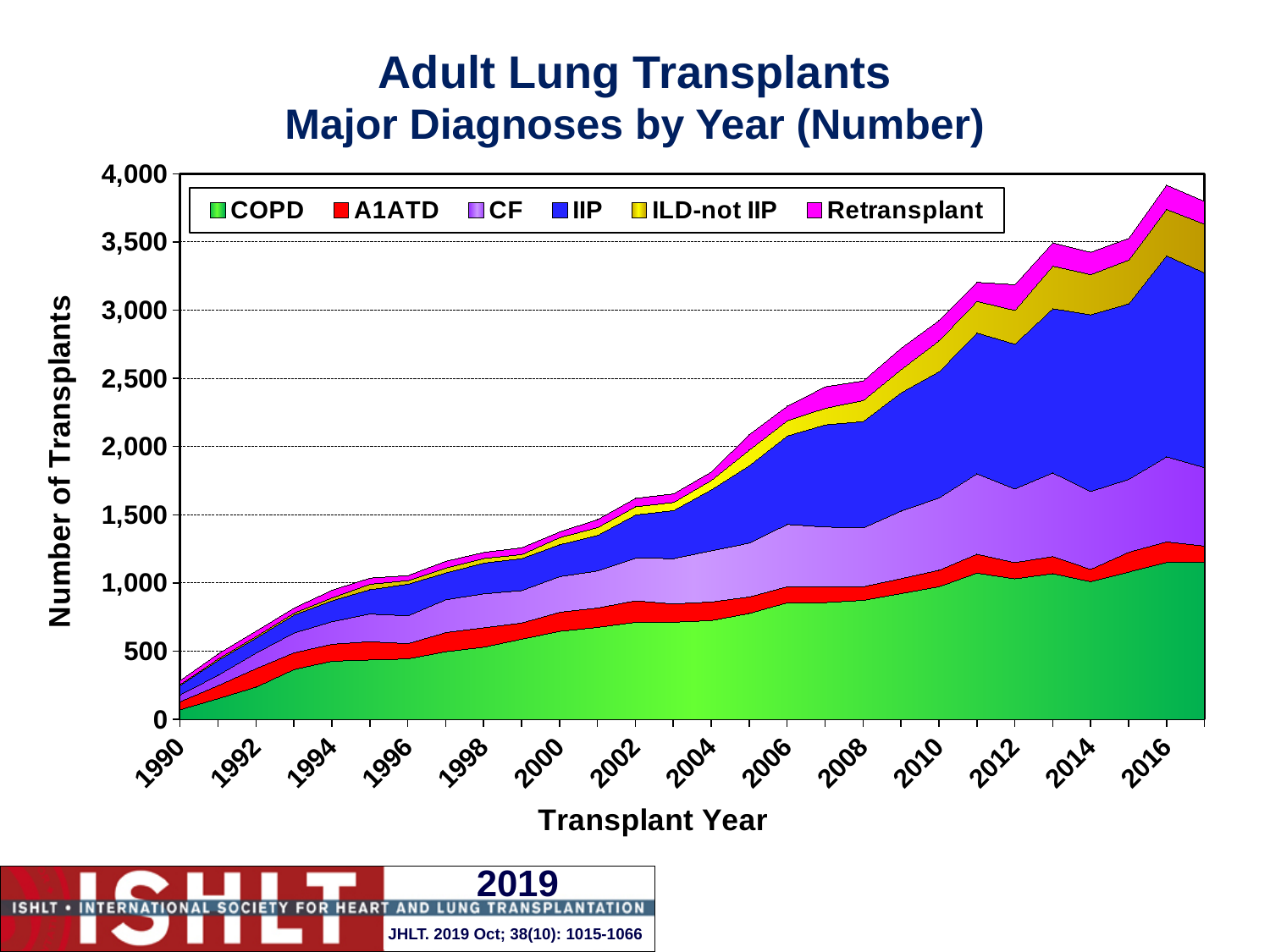
Does the total number of transplants generally rise or fall from 1990 to 2016? Rise What is the label of the y axis? Number of Transplants Is the total number of transplants in 2006 greater or less than 2,000? greater How many series does the legend list? 6 In which year is the total number of transplants lowest? 1990 What is the title of the chart? Adult Lung Transplants Major Diagnoses by Year (Number) Is the total number of transplants in 1990 greater or less than 500? less Which series is plotted at the bottom of the stack? COPD Is the total number of transplants in 2016 greater or less than 3,500? greater What kind of chart is shown on the slide? Stacked area chart Which series has the larger area in 2016, COPD or A1ATD? COPD